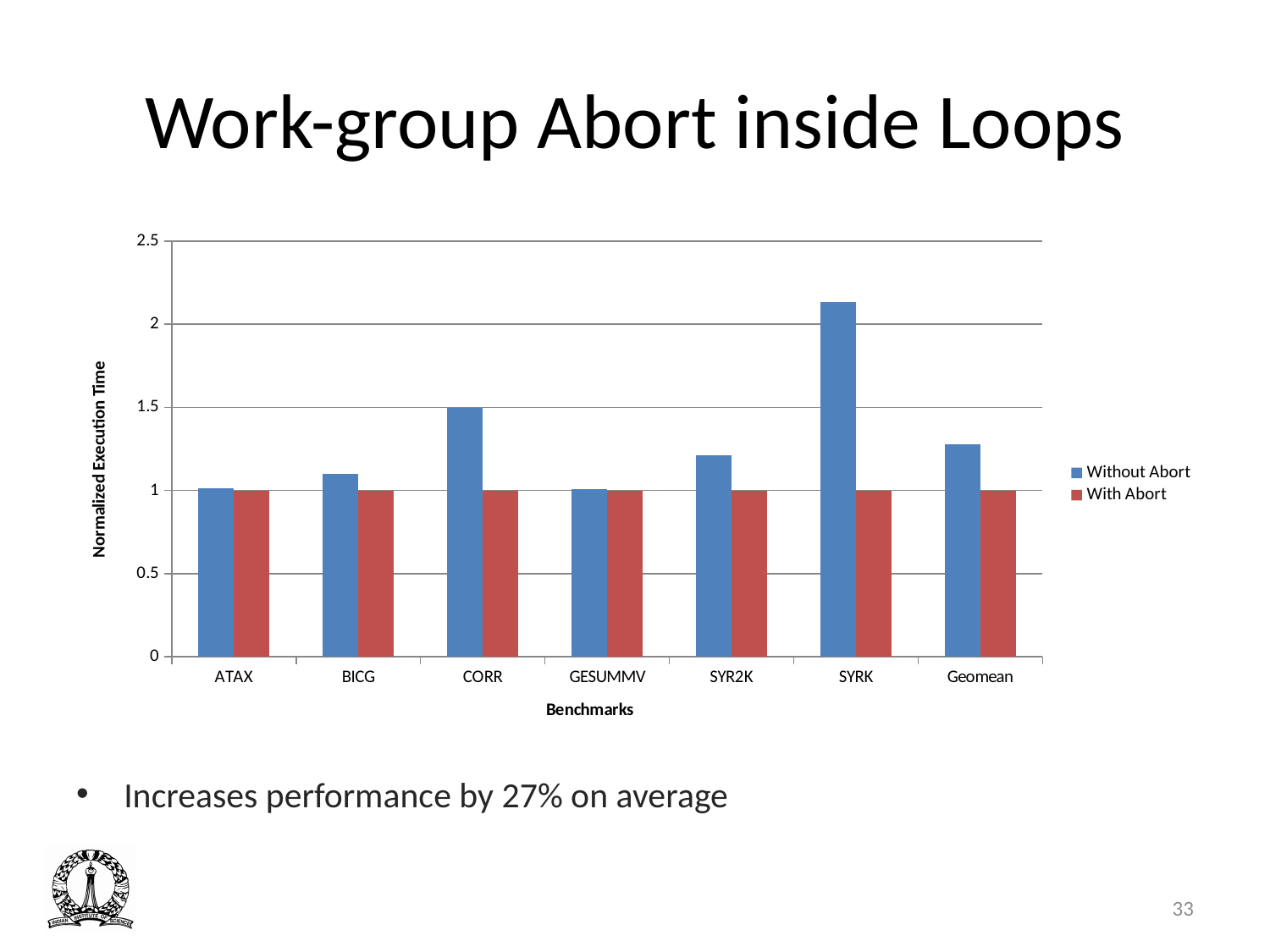
For SYR2K, which series has the larger value, Without Abort or With Abort? Without Abort What kind of chart is shown on the slide? bar chart What is the With Abort value for ATAX? 1 How many series does the legend list? 2 Which is larger, the Without Abort value for SYRK or for CORR? SYRK Is the Without Abort value for Geomean greater or less than 1.5? less Is the Without Abort value for SYRK greater or less than 2? greater What is the label of the y axis? Normalized Execution Time Which benchmark has the highest Without Abort value? SYRK Is the Without Abort value for CORR greater or less than 2? less How many benchmark categories are shown on the x axis? 7 What are the two entries in the legend? Without Abort, With Abort